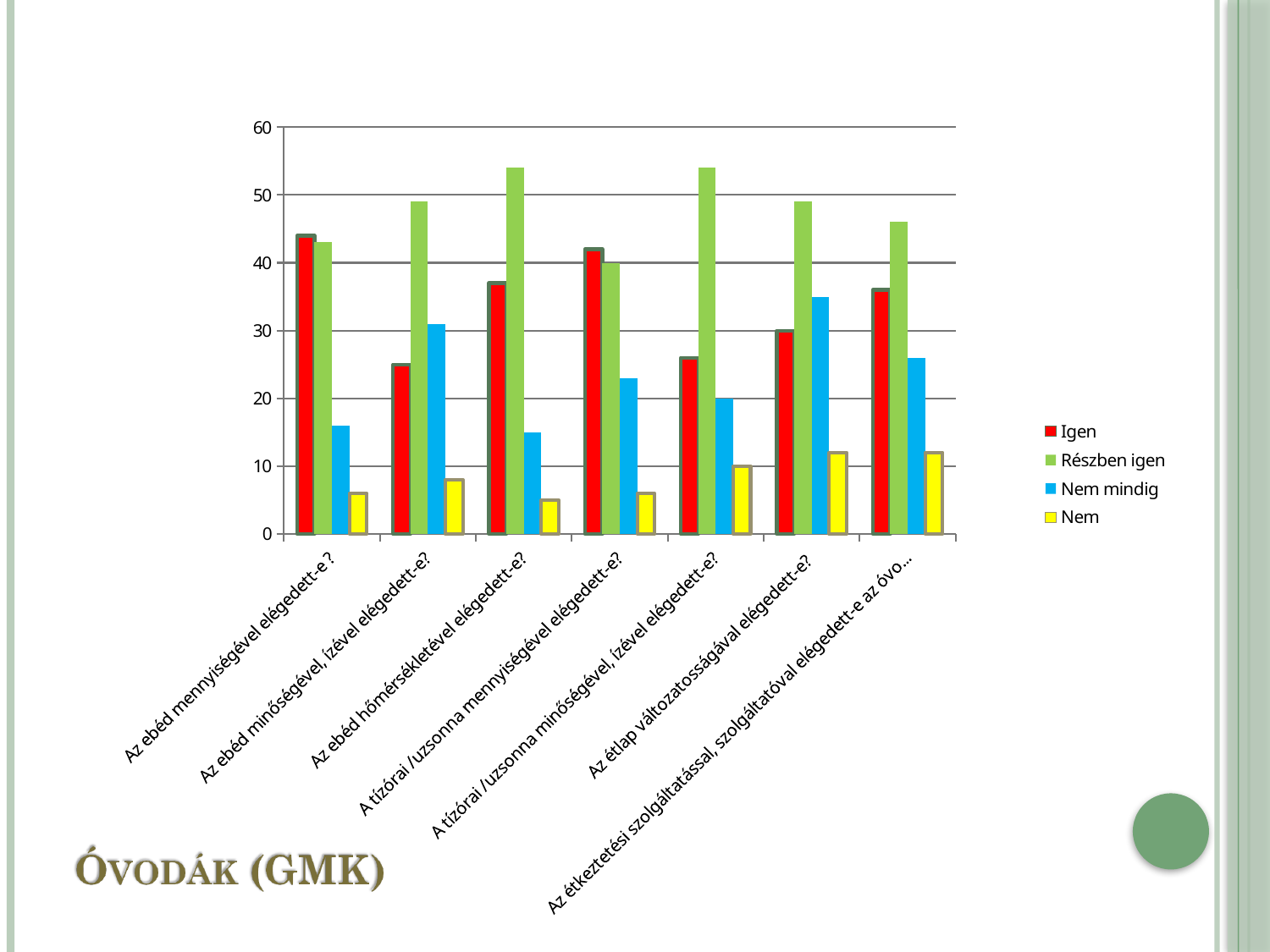
Is the 'Részben igen' value for 'Az ebéd hőmérsékletével elégedett-e?' greater or less than 50? greater How many question categories are shown on the x axis? 7 Is the 'Nem mindig' value for 'Az ebéd hőmérsékletével elégedett-e?' greater or less than 20? less For 'Az ebéd minőségével, ízével elégedett-e?', which is larger: 'Igen' or 'Nem mindig'? Nem mindig What kind of chart is shown on the slide? bar chart Which category has the highest 'Nem mindig' value? Az étlap változatosságával elégedett-e? Which series has the lowest value for 'Az ebéd mennyiségével elégedett-e ?'? Nem What colour represents the 'Nem' series in the legend? yellow Is the 'Igen' value for 'Az ebéd mennyiségével elégedett-e ?' greater or less than 40? greater How many series does the legend list? 4 For 'Az ebéd hőmérsékletével elégedett-e?', which is larger: 'Igen' or 'Részben igen'? Részben igen